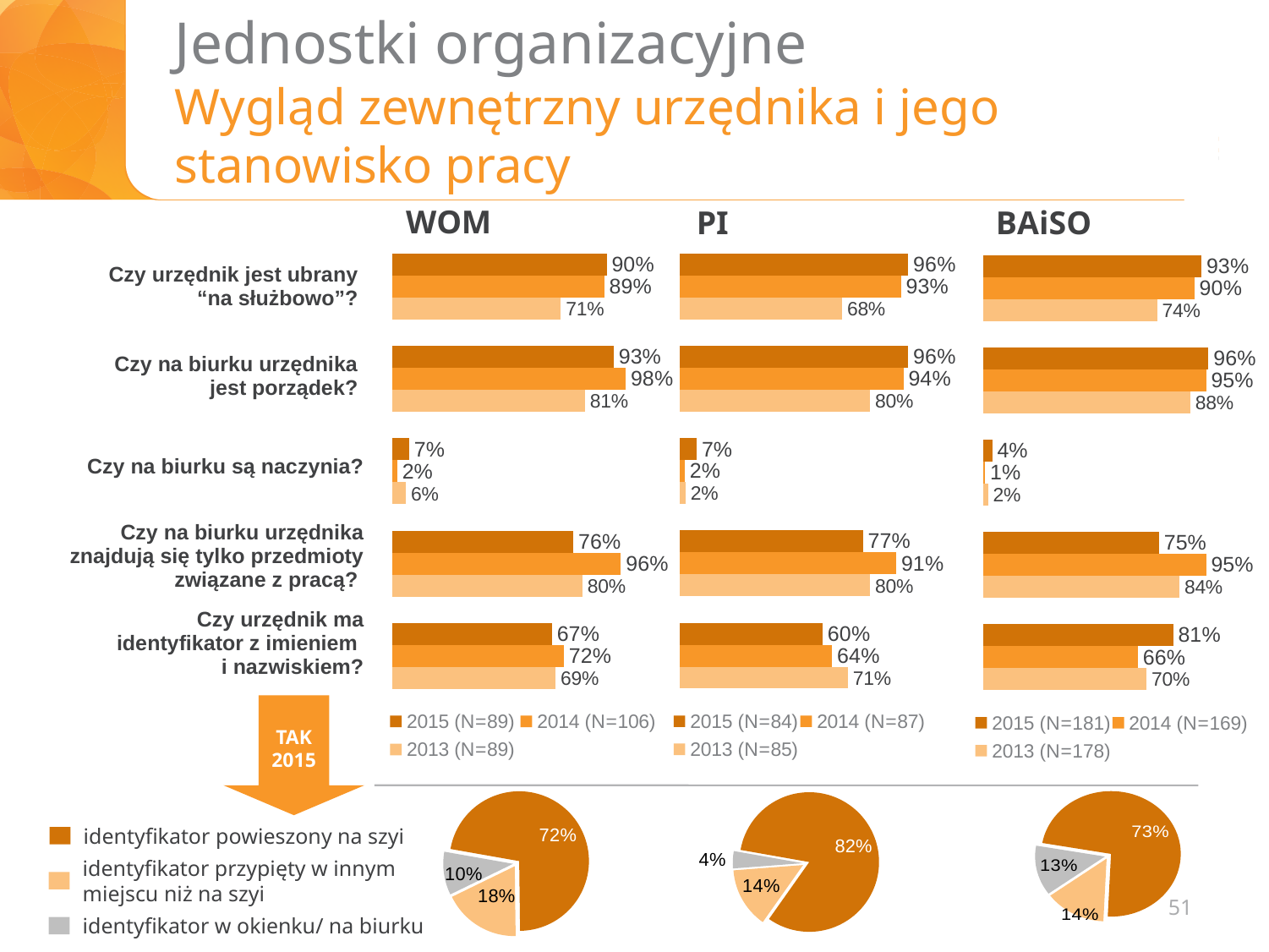
In the PI bar chart, which is larger for "Czy urzędnik ma identyfikator z imieniem i nazwiskiem?": the 2015 value or the 2013 value? 2013 In the WOM bar chart, what is the 2015 value for "Czy urzędnik jest ubrany "na służbowo"?"? 90% In the BAiSO bar chart, which question has the lowest 2015 value? Czy na biurku są naczynia? How many questions (categories) are shown in the PI bar chart? 5 In the BAiSO bar chart, what is the 2014 value for "Czy urzędnik ma identyfikator z imieniem i nazwiskiem?"? 66% In the PI pie chart at the bottom, what share is the largest slice? 82% In the PI bar chart, what is the 2013 value for "Czy na biurku urzędnika jest porządek?"? 80% How many series does the legend of the WOM bar chart list? 3 In the WOM bar chart, what is the difference between the 2014 and 2015 values for "Czy na biurku urzędnika znajdują się tylko przedmioty związane z pracą?"? 20% In the BAiSO pie chart at the bottom, what is the share for "identyfikator w okienku/ na biurku"? 13% What sample size (N) is given for 2015 in the BAiSO bar chart legend? N=181 What kind of chart is used for the WOM, PI and BAiSO data in the upper part of the slide? Bar chart